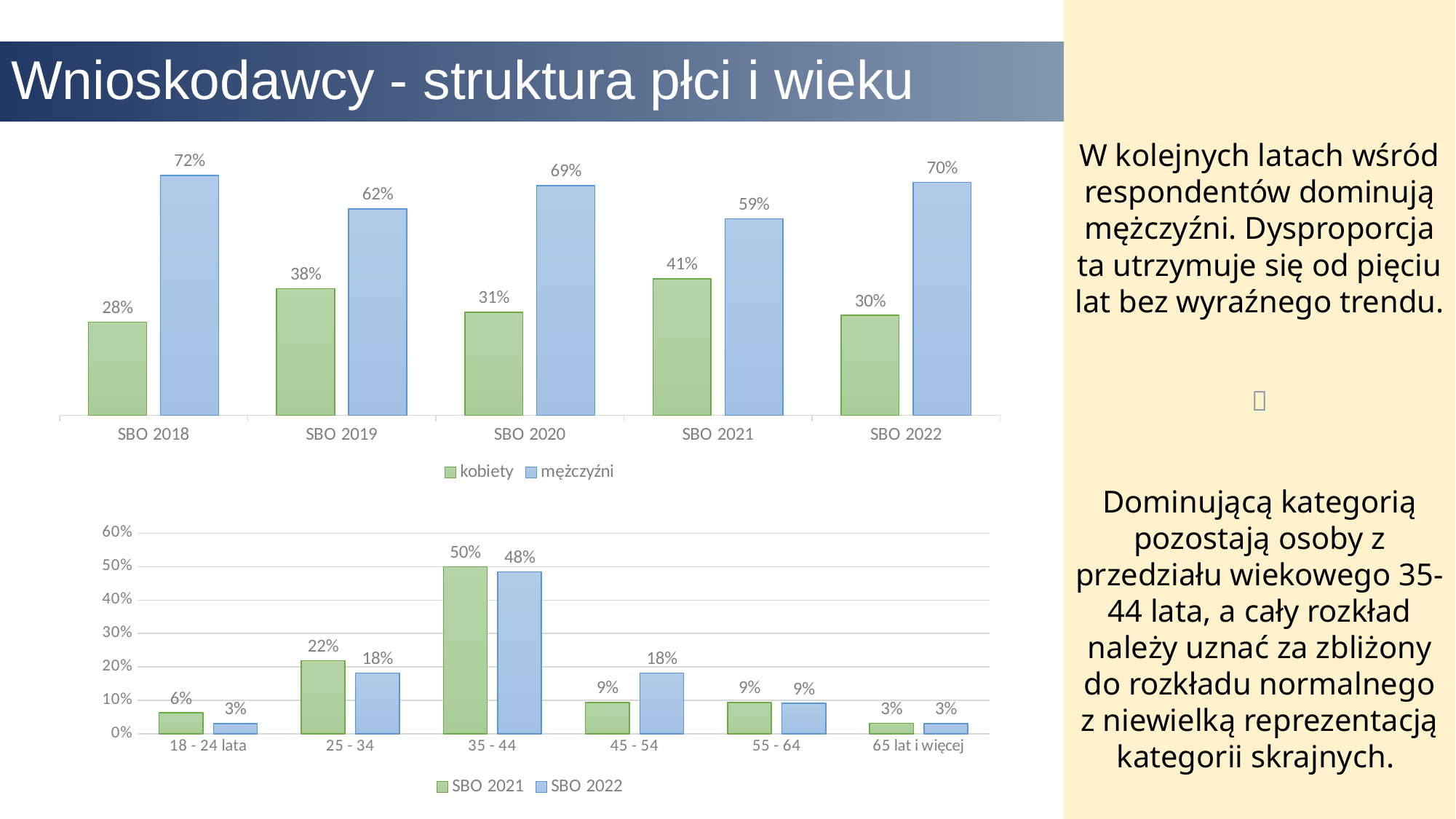
What kind of chart is the bottom chart? bar chart In the bottom chart, which age category has the highest value for SBO 2021? 35 - 44 In the top chart, what is the value for kobiety in SBO 2021? 41% In the bottom chart, how many age categories are shown on the x axis? 6 In the bottom chart, what is the value for SBO 2022 in the 45 - 54 category? 18% In the top chart, which year has the highest value for kobiety? SBO 2021 In the top chart, what is the value for mężczyźni in SBO 2018? 72% In the top chart, what is the difference between mężczyźni and kobiety in SBO 2022? 40% In the top chart, how many series does the legend list? 2 In the bottom chart, which is larger in the 25 - 34 category, SBO 2021 or SBO 2022? SBO 2021 In the bottom chart, what is the difference between SBO 2021 and SBO 2022 in the 18 - 24 lata category? 3% In the top chart, which year has the lowest value for mężczyźni? SBO 2021